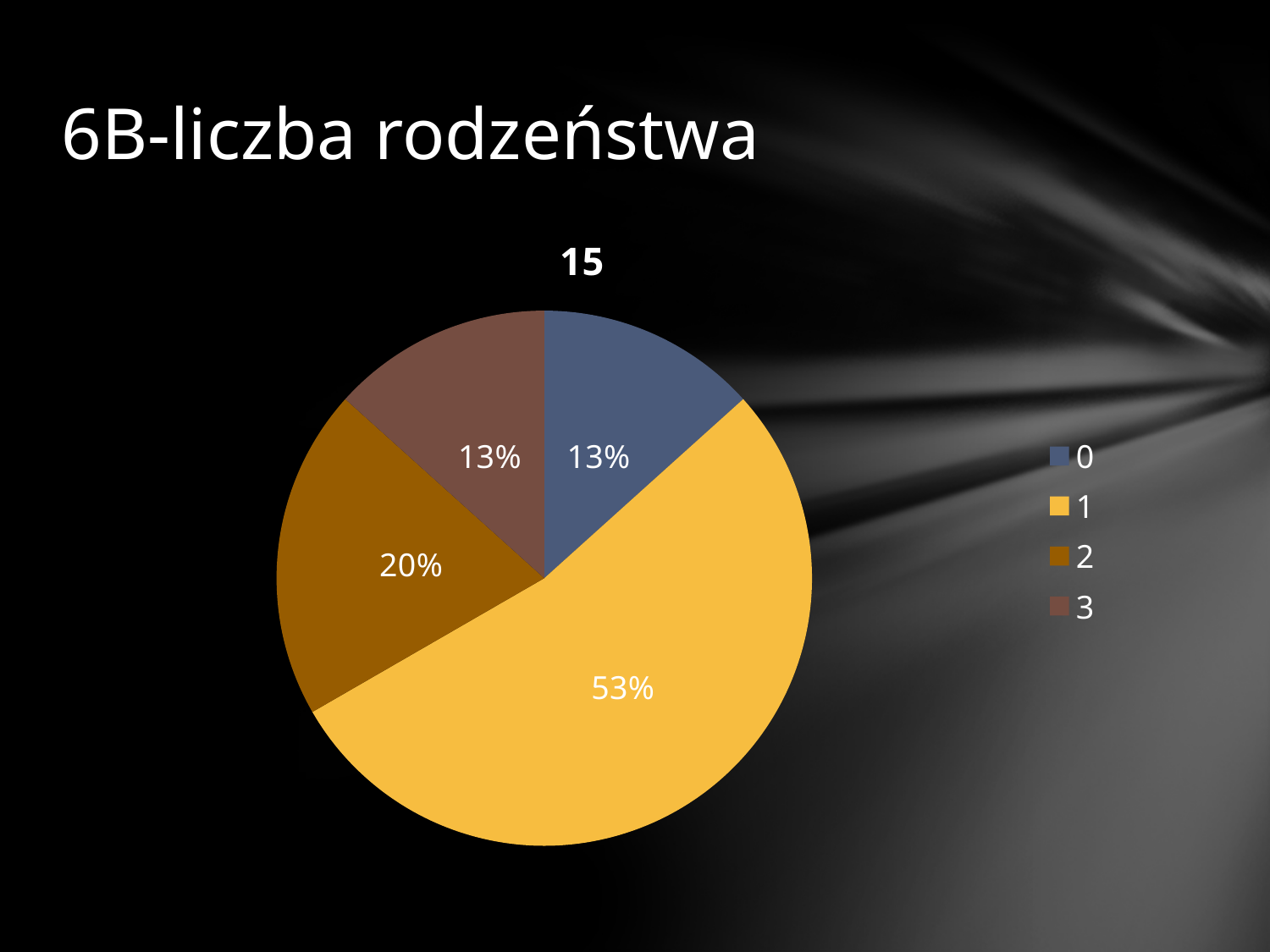
What share of the pie does category 3 have? 13% What is the title shown above the pie chart? 15 What share of the pie does category 1 have? 53% How many slices does the pie chart have? 4 What share of the pie does category 2 have? 20% Which is larger, the slice for category 2 or the slice for category 3? 2 What is the title of the slide? 6B-liczba rodzeństwa What kind of chart is shown on the slide? pie chart What share of the pie does category 0 have? 13% Which category has the largest slice of the pie? 1 What is the difference in percentage points between the slice for category 2 and the slice for category 0? 7 What is the difference in percentage points between the slice for category 1 and the slice for category 2? 33